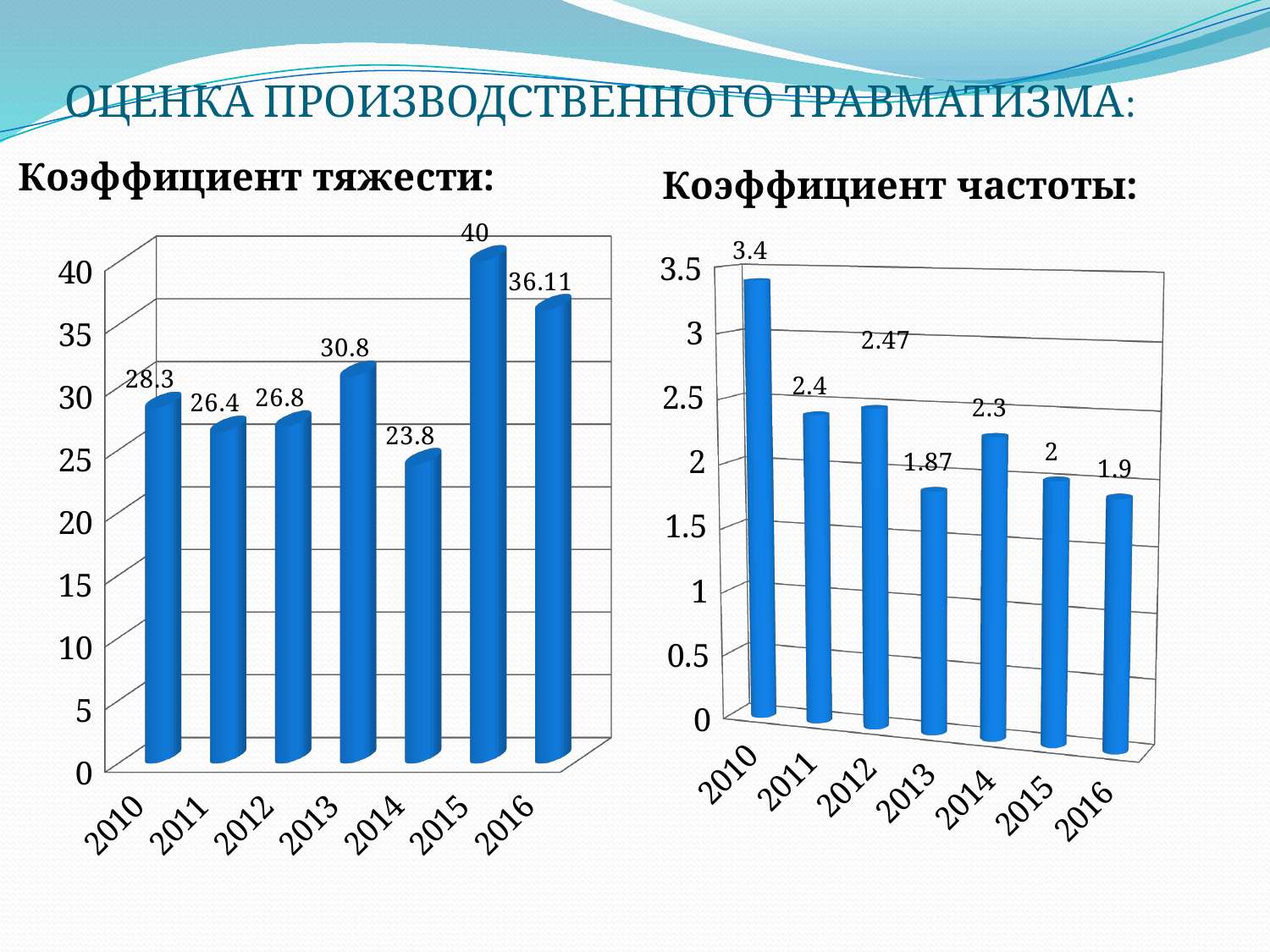
In the left chart (Коэффициент тяжести), what is the difference between the values for 2015 and 2016? 3.89 In the left chart (Коэффициент тяжести), which year has the lowest value? 2014 In the left chart (Коэффициент тяжести), what is the value for 2013? 30.8 In the right chart (Коэффициент частоты), which is larger, the value for 2011 or the value for 2014? 2011 In the right chart (Коэффициент частоты), which year has the highest value? 2010 In the right chart (Коэффициент частоты), which year has the lowest value? 2013 In the left chart (Коэффициент тяжести), which year has the highest value? 2015 In the right chart (Коэффициент частоты), what is the difference between the values for 2010 and 2016? 1.5 In the left chart (Коэффициент тяжести), what is the value for 2010? 28.3 What kind of chart is the right chart (Коэффициент частоты)? Bar chart In the right chart (Коэффициент частоты), what is the value for 2012? 2.47 In the left chart (Коэффициент тяжести), how many years are shown on the x axis? 7